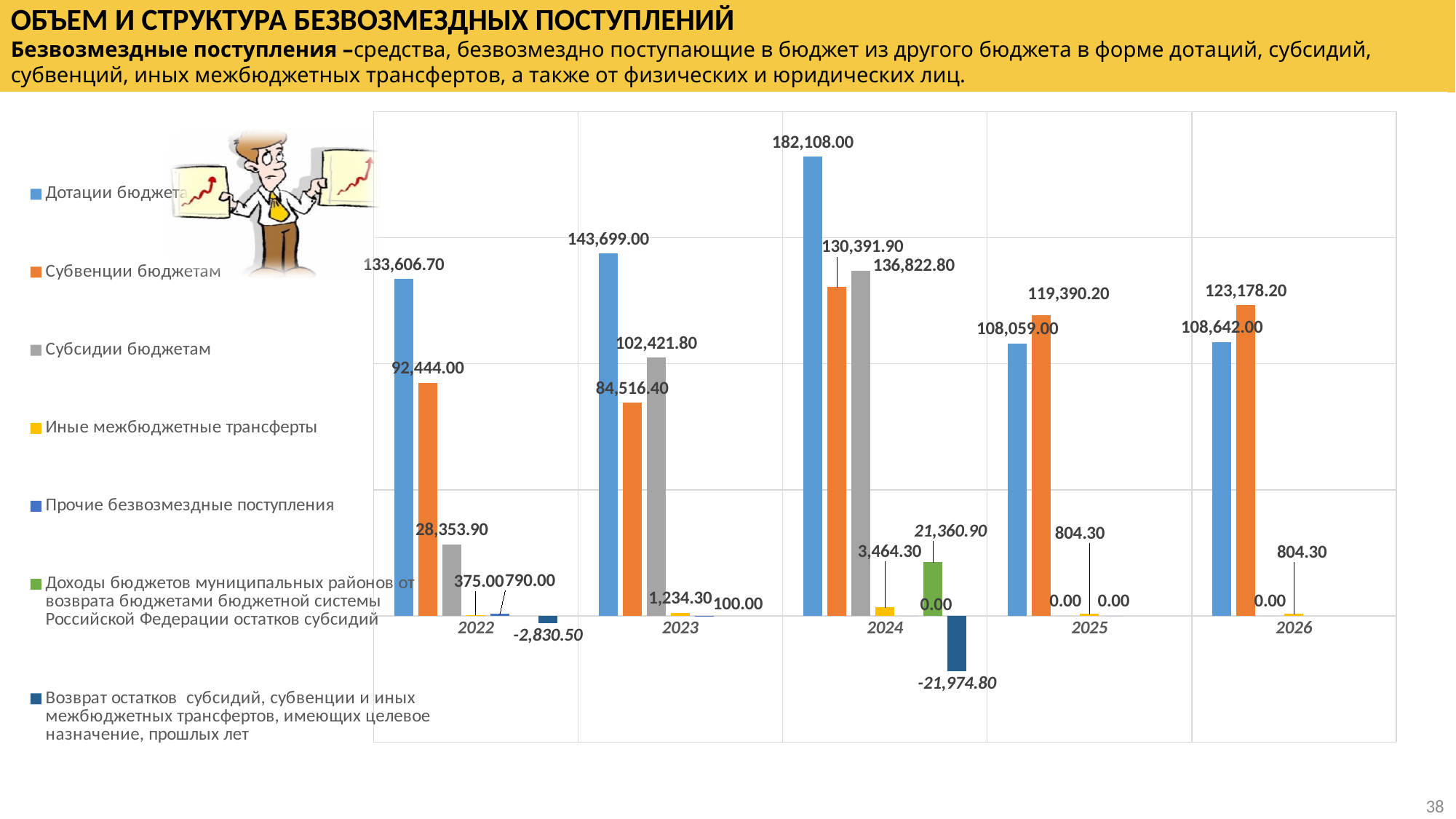
What is the difference between Дотации бюджета in 2023 and in 2022? 10,092.30 What is the value of Дотации бюджета in 2024? 182,108.00 How many years are shown on the x axis of the chart? 5 Does Дотации бюджета rise or fall from 2022 to 2024? Rise What is the value of Возврат остатков субсидий, субвенции и иных межбюджетных трансфертов in 2024? -21,974.80 In 2025, which is larger: Дотации бюджета or Субвенции бюджетам? Субвенции бюджетам What is the value of Субсидии бюджетам in 2023? 102,421.80 How many series does the legend list? 7 In which year is Дотации бюджета the highest? 2024 What is the value of Субвенции бюджетам in 2022? 92,444.00 What is the value of Субвенции бюджетам in 2026? 123,178.20 What kind of chart is shown on the slide? Bar chart